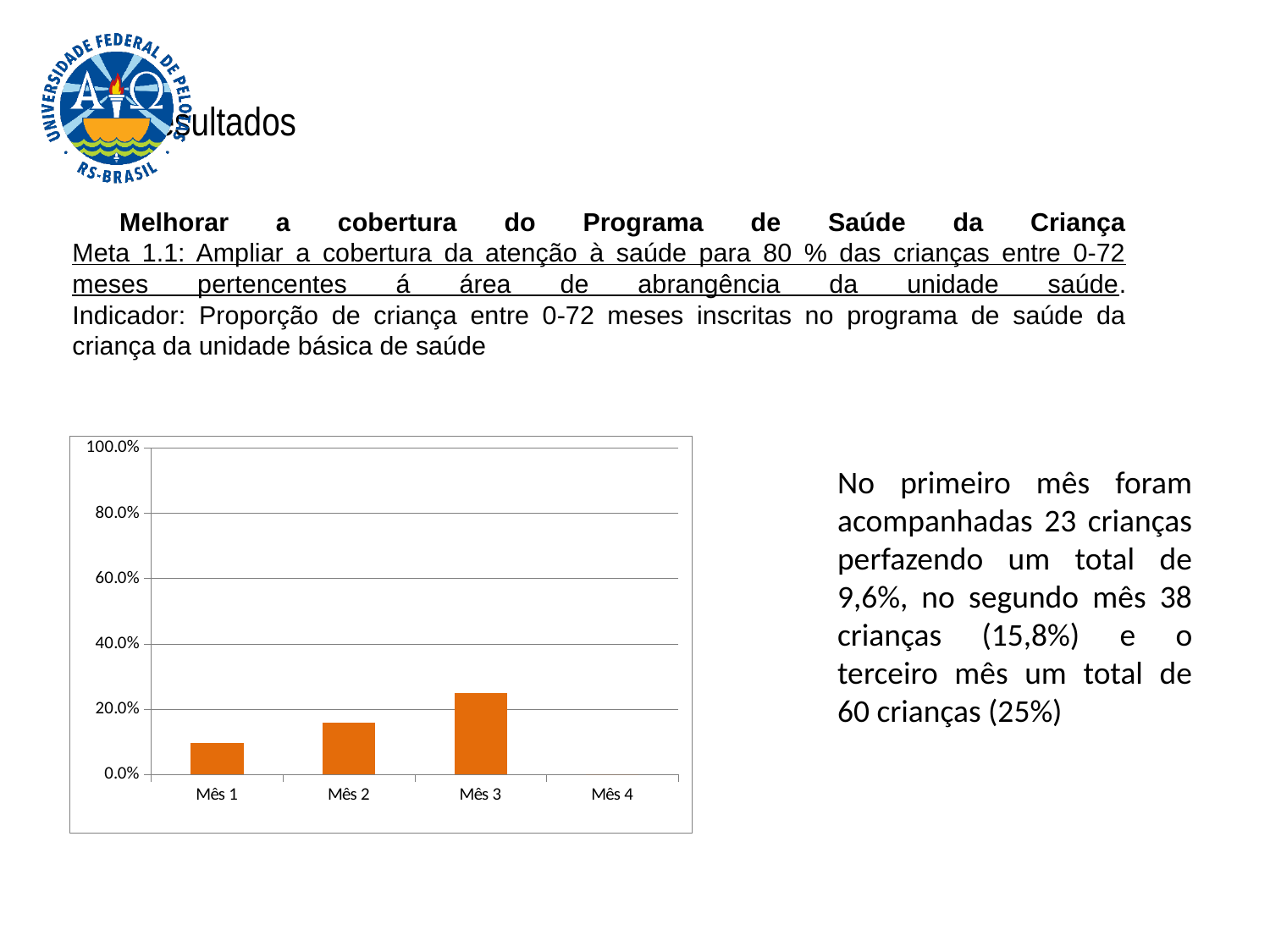
Is the value for Mês 2 greater or less than 20.0%? less Which is larger, the value for Mês 3 or the value for Mês 1? Mês 3 Do the bar values rise or fall from Mês 1 to Mês 3? rise Is the value for Mês 3 greater or less than 40.0%? less Among Mês 1, Mês 2 and Mês 3, which month has the shortest bar? Mês 1 How many categories are shown on the x axis of the chart? 4 Which category on the x axis has no bar plotted? Mês 4 Is the value for Mês 1 greater or less than 20.0%? less Which month has the tallest bar in the chart? Mês 3 What kind of chart is shown on the slide? bar chart What is the highest value shown on the chart's y axis? 100.0%